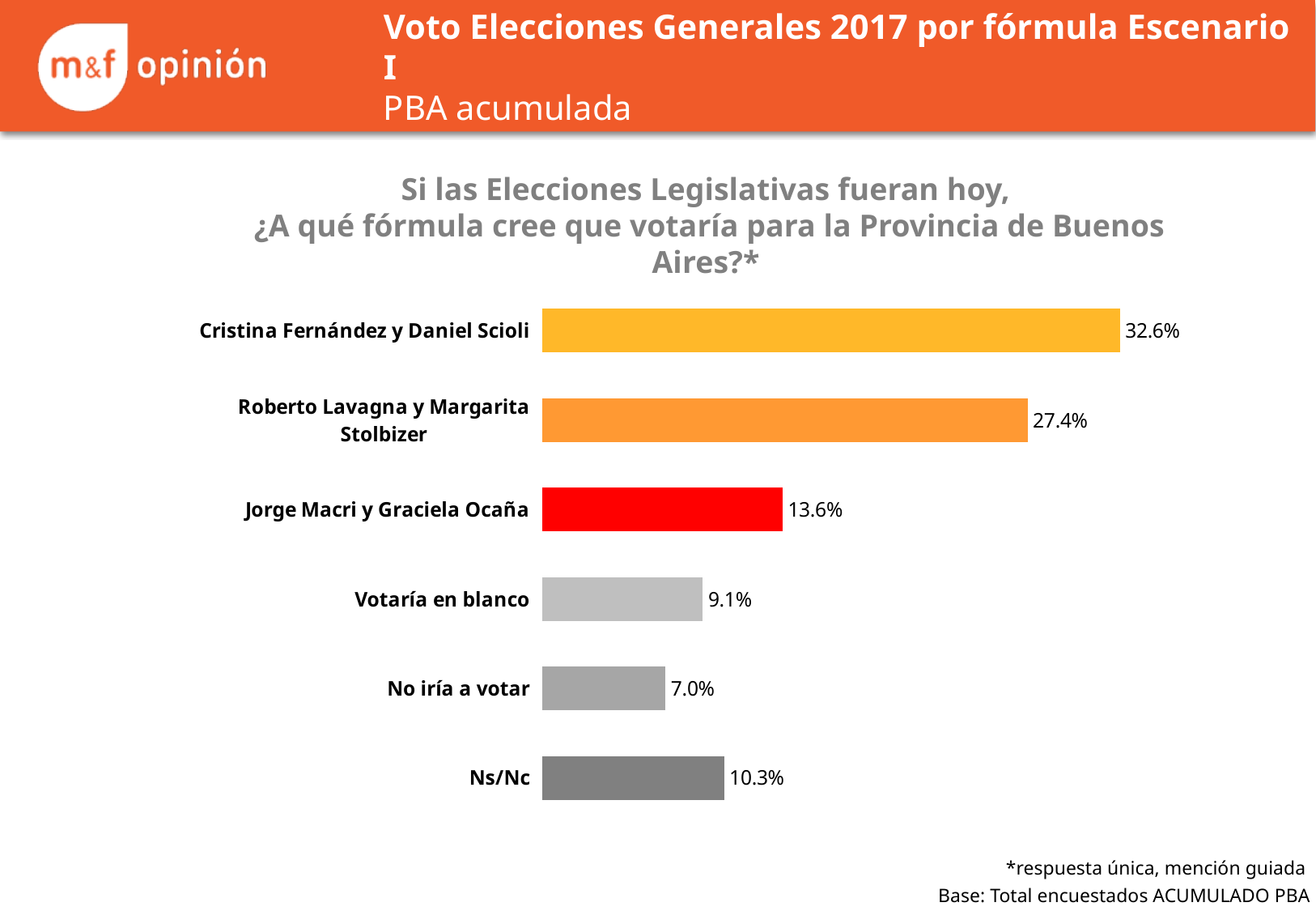
What is the value for Votaría en blanco? 9.1% What is the difference between Ns/Nc and No iría a votar? 3.3% What kind of chart is shown on the slide? Bar chart How many categories are shown in the chart? 6 Which category has the highest value? Cristina Fernández y Daniel Scioli What is the difference between Cristina Fernández y Daniel Scioli and Roberto Lavagna y Margarita Stolbizer? 5.2% Which is larger, Votaría en blanco or Ns/Nc? Ns/Nc What percentage would vote for Cristina Fernández y Daniel Scioli? 32.6% What is the value for Jorge Macri y Graciela Ocaña? 13.6% What colour is the bar for Jorge Macri y Graciela Ocaña? Red What percentage is shown for Ns/Nc? 10.3% Which category has the lowest value? No iría a votar